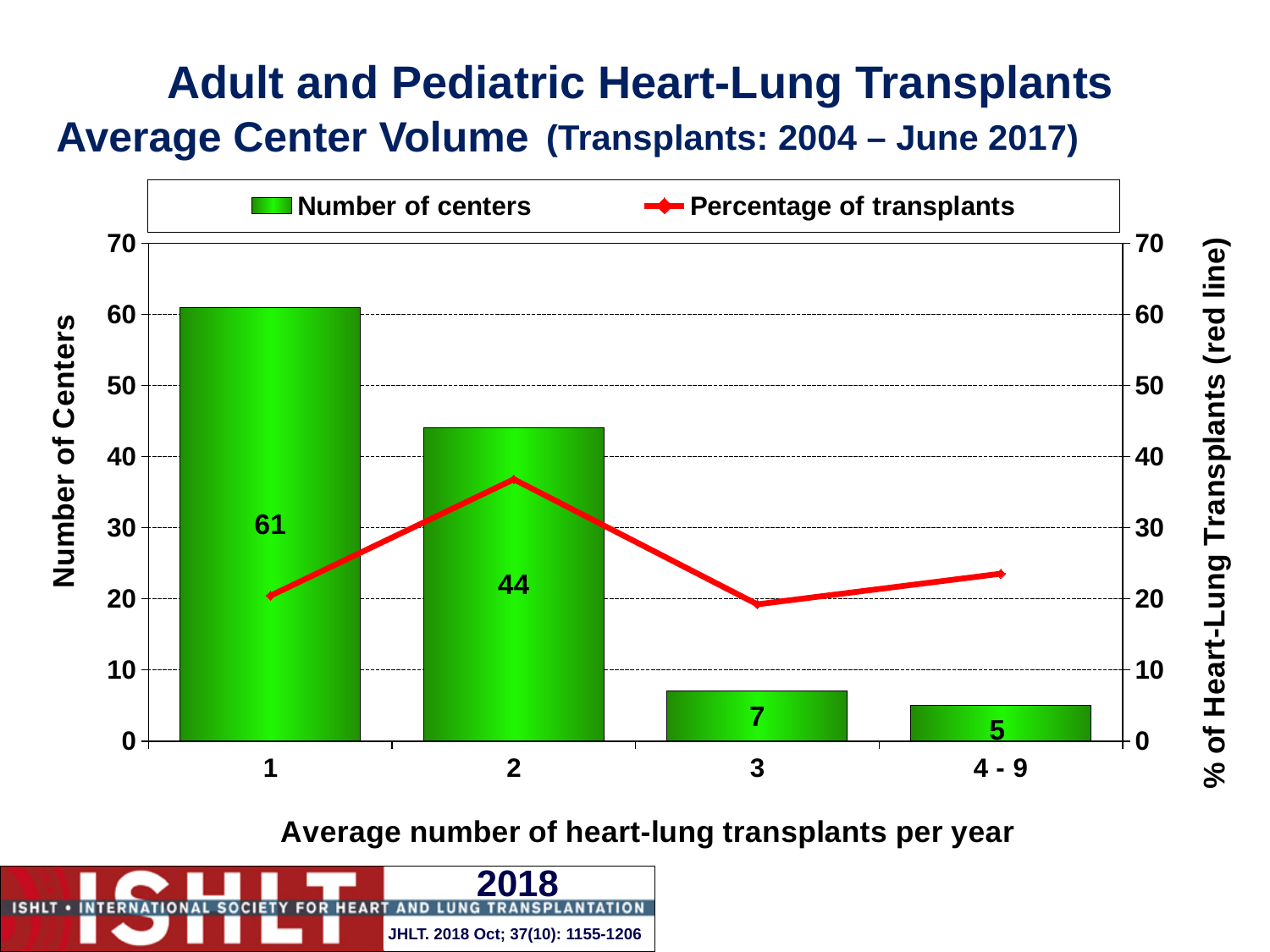
Which category has the highest percentage of transplants on the red line? 2 Which category has the highest number of centers? 1 How many series does the legend list? 2 What is the number of centers for the '2' average transplants per year category? 44 How many centers have an average of 1 heart-lung transplant per year? 61 What is the difference in number of centers between the '1' and '2' categories? 17 Is the percentage of transplants for the '2' category greater or less than 30? greater Is the percentage of transplants for the '3' category greater or less than 30? less Which has more centers, the '3' category or the '4 - 9' category? 3 Which category has the lowest number of centers? 4 - 9 What is the number of centers for the '4 - 9' category? 5 How many categories are shown on the x axis? 4